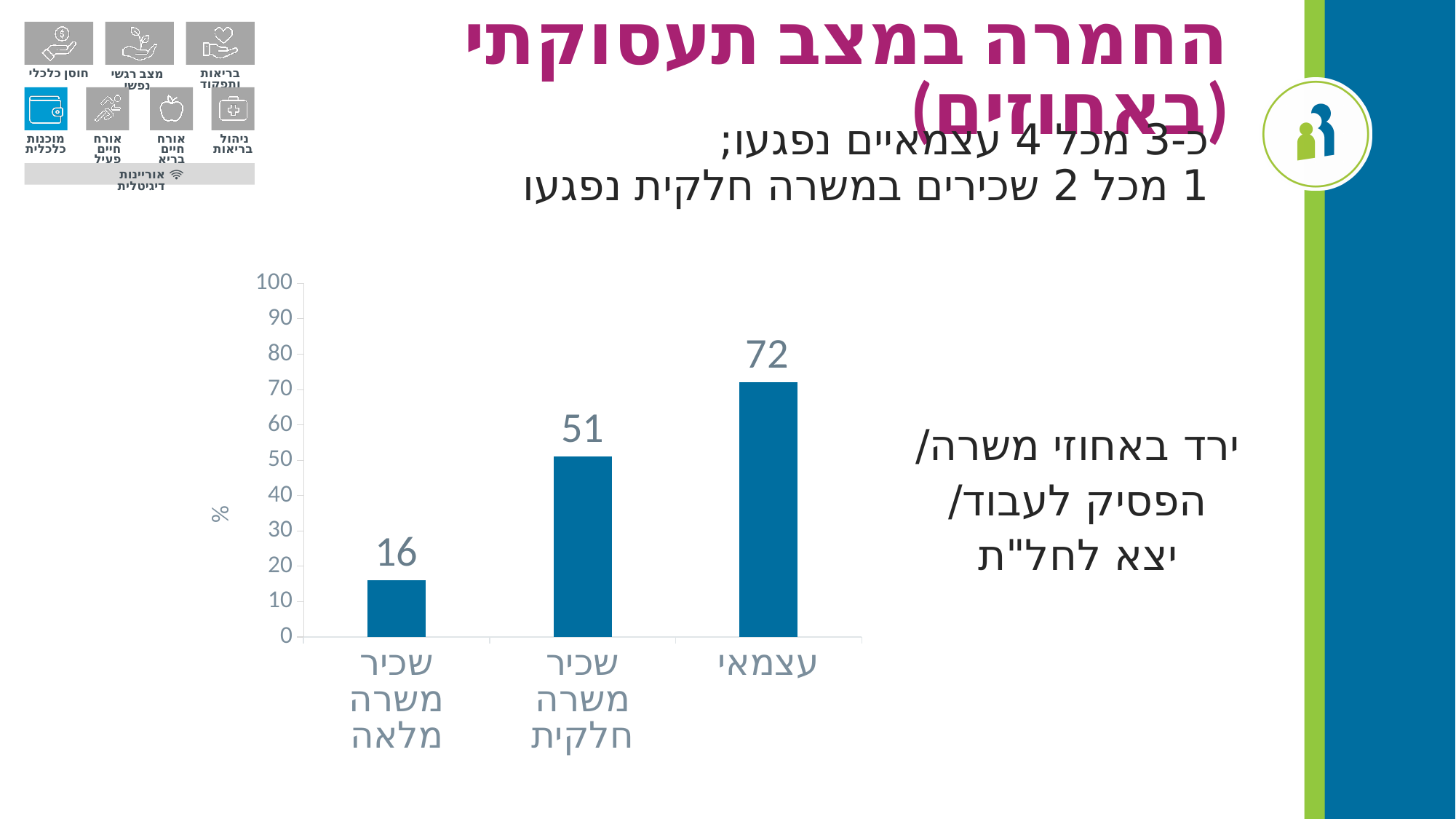
What is the value for שכיר משרה חלקית? 51 What is the difference between the values for עצמאי and שכיר משרה חלקית? 21 What is the value for עצמאי? 72 What is the label on the vertical axis of the chart? % What is the difference between the values for עצמאי and שכיר משרה מלאה? 56 How many categories are shown on the x axis? 3 Is the value for עצמאי greater or less than 70? greater Which category has the highest value? עצמאי What is the value for שכיר משרה מלאה? 16 Which is larger, the value for שכיר משרה חלקית or the value for שכיר משרה מלאה? שכיר משרה חלקית What kind of chart is shown on the slide? bar chart Which category has the lowest value? שכיר משרה מלאה